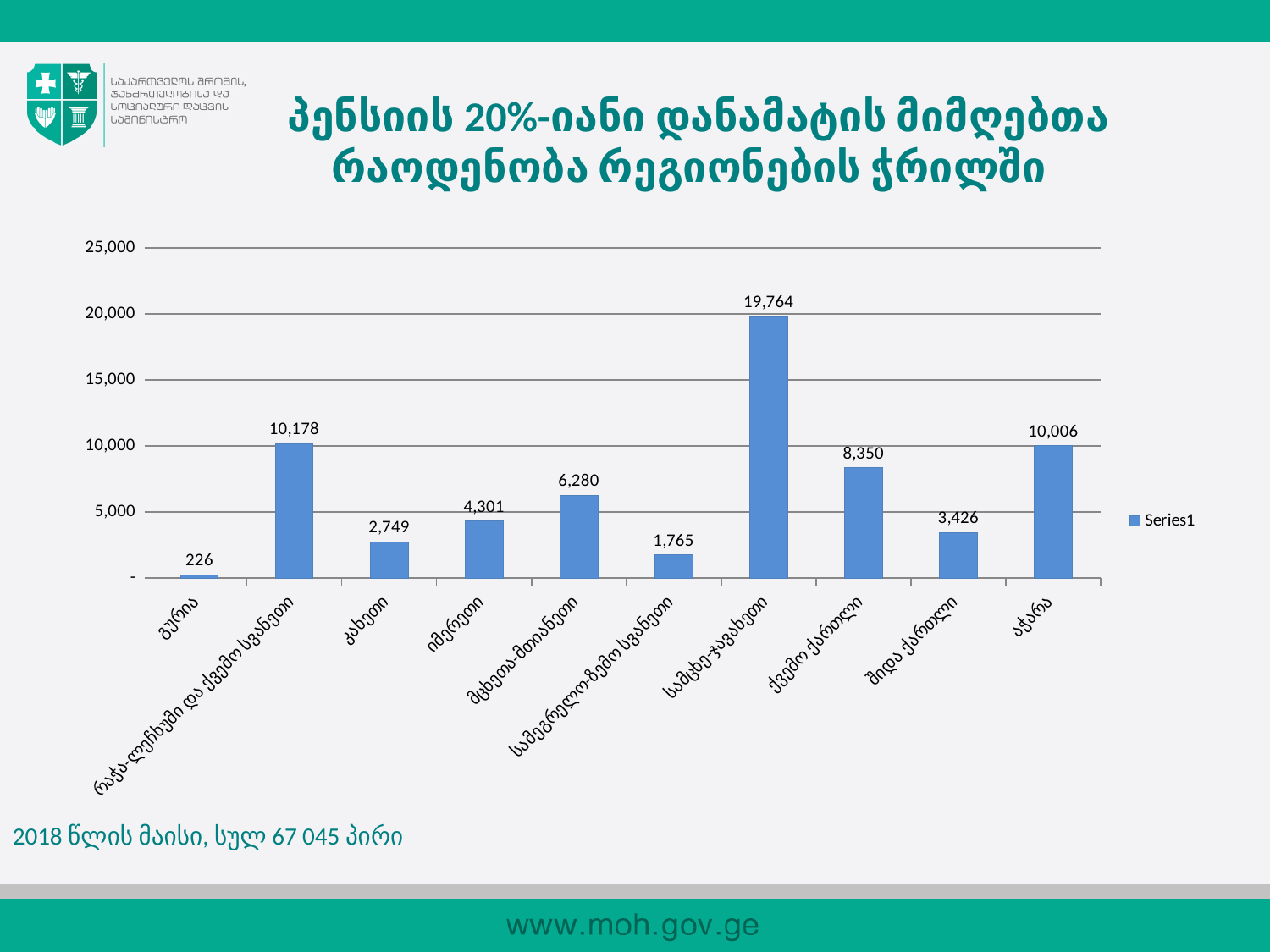
Which category has the highest value? სამცხე-ჯავახეთი What kind of chart is shown on the slide? bar chart What is the difference between the values for ქვემო ქართლი and შიდა ქართლი? 4,924 Is the value for მცხეთა-მთიანეთი greater or less than 5,000? greater What is the value for აჭარა? 10,006 How many categories are shown on the x axis? 10 Which category has the lowest value? გურია What is the value for გურია? 226 What is the legend entry shown for the series? Series1 What is the value for იმერეთი? 4,301 What is the value for სამცხე-ჯავახეთი? 19,764 Which is larger, the value for რაჭა-ლეჩხუმი და ქვემო სვანეთი or the value for აჭარა? რაჭა-ლეჩხუმი და ქვემო სვანეთი